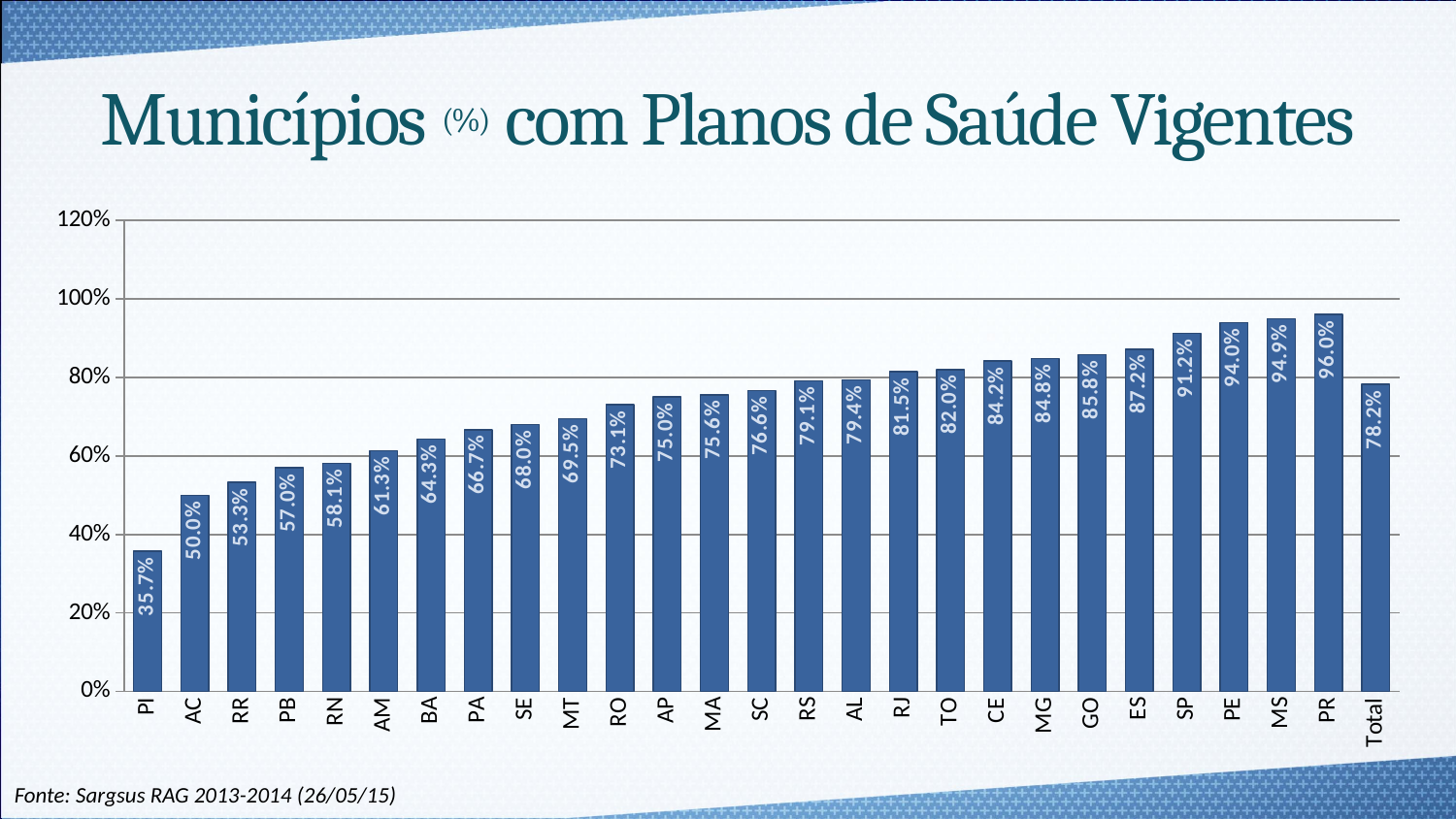
Is the value for AC greater or less than 60%? less Do the state values rise or fall from left to right along the x axis (excluding the Total bar)? Rise What is the value for the Total bar? 78.2% Which is larger, the value for BA or the value for RO? RO What is the value for PI? 35.7% How many bars are plotted in the chart, including Total? 27 What is the difference between the values for MS and PE? 0.9 percentage points What is the value for SP? 91.2% Which state has the highest value? PR Which state has the lowest value? PI What kind of chart is shown on the slide? Bar chart What is the difference between the values for PR and PI? 60.3 percentage points